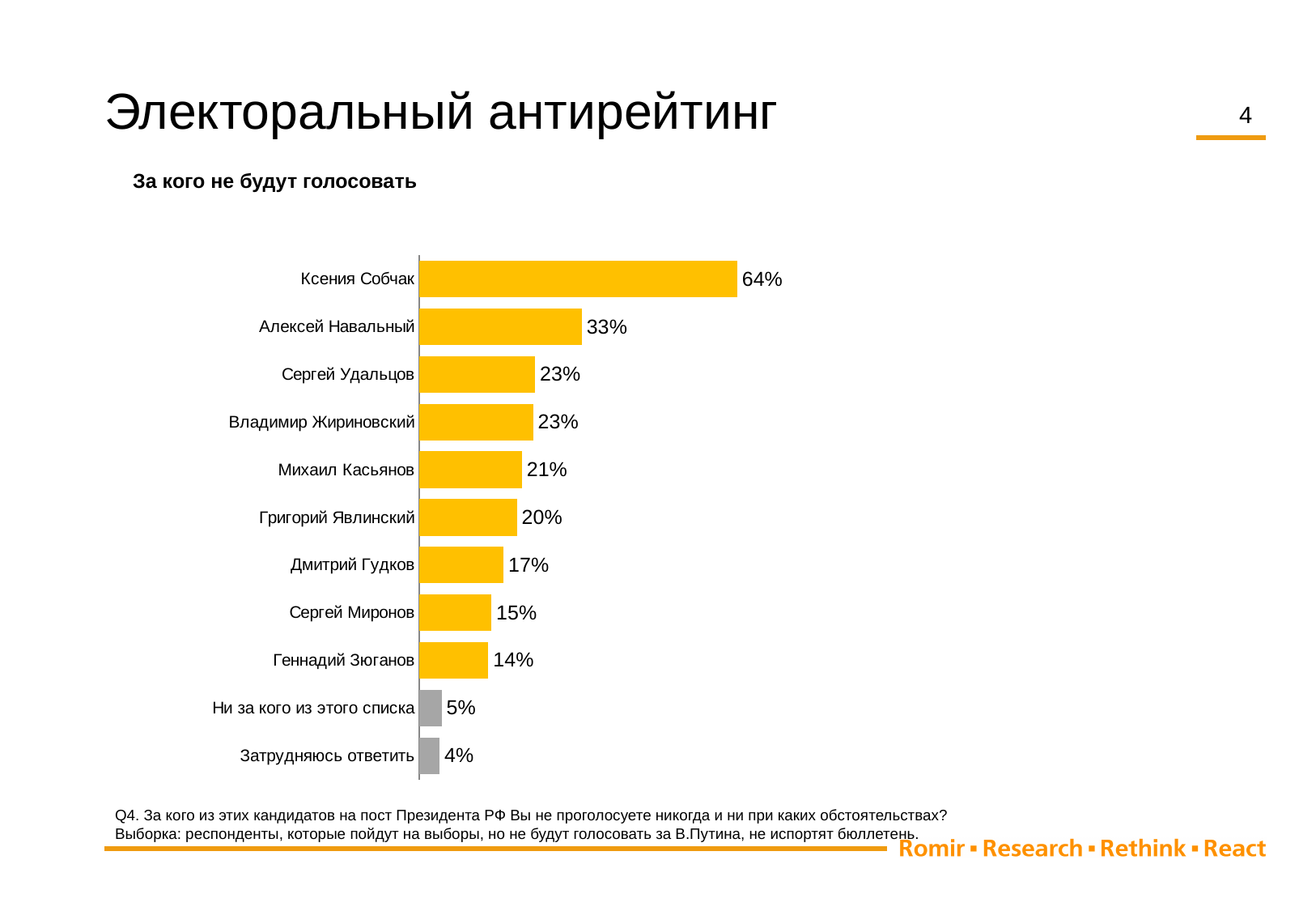
What kind of chart is shown on the slide? Bar chart What is the difference between the values for Ксения Собчак and Алексей Навальный? 31% Which is larger, the value for Григорий Явлинский or the value for Сергей Миронов? Григорий Явлинский Which category has the lowest value? Затрудняюсь ответить What is the value for Михаил Касьянов? 21% What is the difference between the values for Дмитрий Гудков and Геннадий Зюганов? 3% What is the value for Затрудняюсь ответить? 4% Which two categories have bars coloured grey instead of yellow? Ни за кого из этого списка and Затрудняюсь ответить How many categories are shown in the chart? 11 Which category has the highest value? Ксения Собчак What is the value for Ксения Собчак? 64% What is the subtitle shown above the chart? За кого не будут голосовать